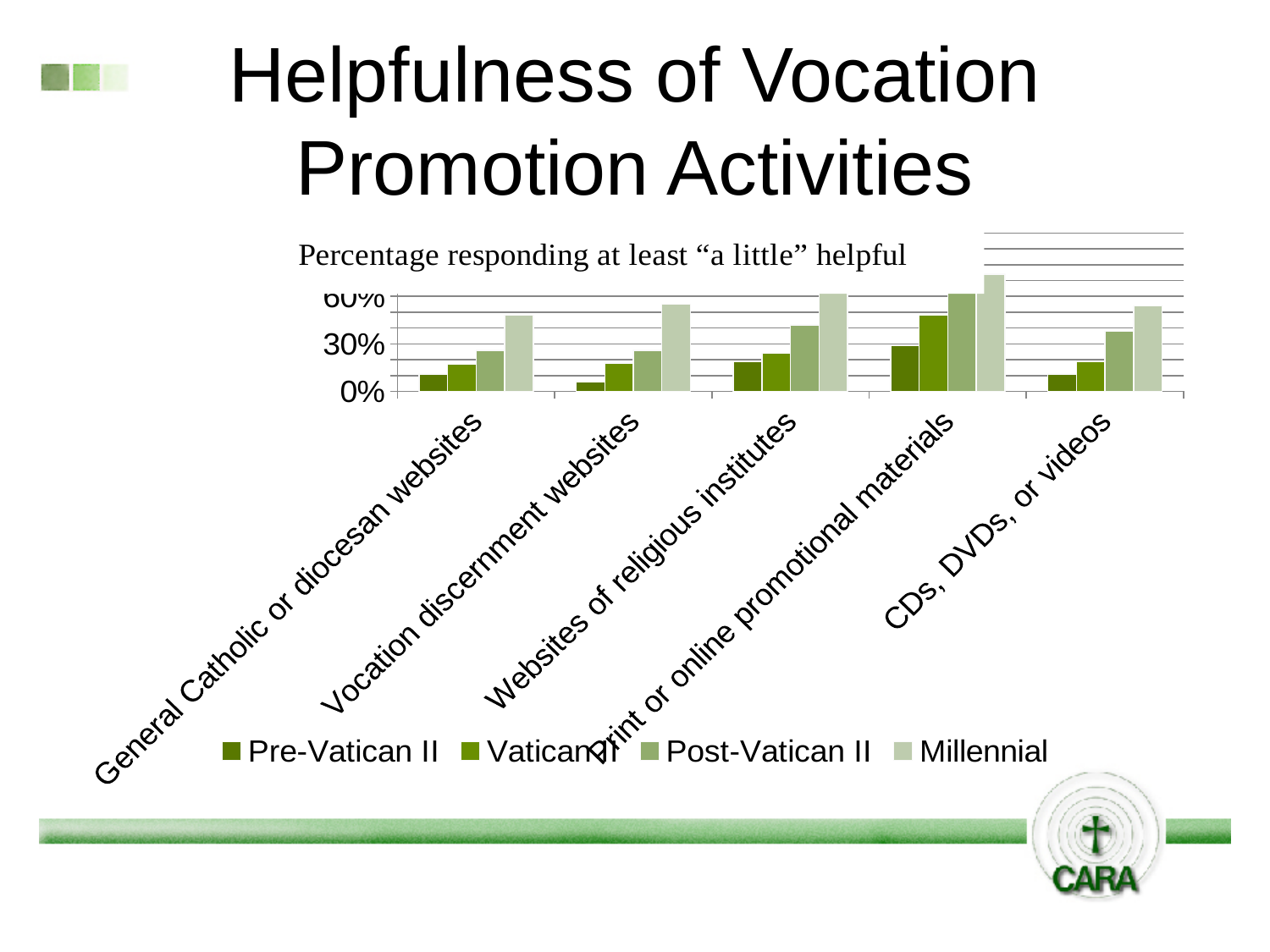
What kind of chart is shown on the slide? Bar chart For which activity is the Pre-Vatican II value lowest? Vocation discernment websites Which series are listed in the legend? Pre-Vatican II, Vatican II, Post-Vatican II, Millennial How many vocation promotion activities (categories) are shown on the x axis? 5 Is the Post-Vatican II value for Websites of religious institutes greater or less than 60%? less What does the subtitle above the chart say the percentages represent? Percentage responding at least "a little" helpful Is the Millennial value for General Catholic or diocesan websites greater or less than 30%? greater For CDs, DVDs, or videos, which is larger: the Millennial value or the Pre-Vatican II value? Millennial For which activity is the Millennial value highest? Print or online promotional materials How many series does the legend list? 4 Is the Millennial value for Print or online promotional materials greater or less than 60%? greater